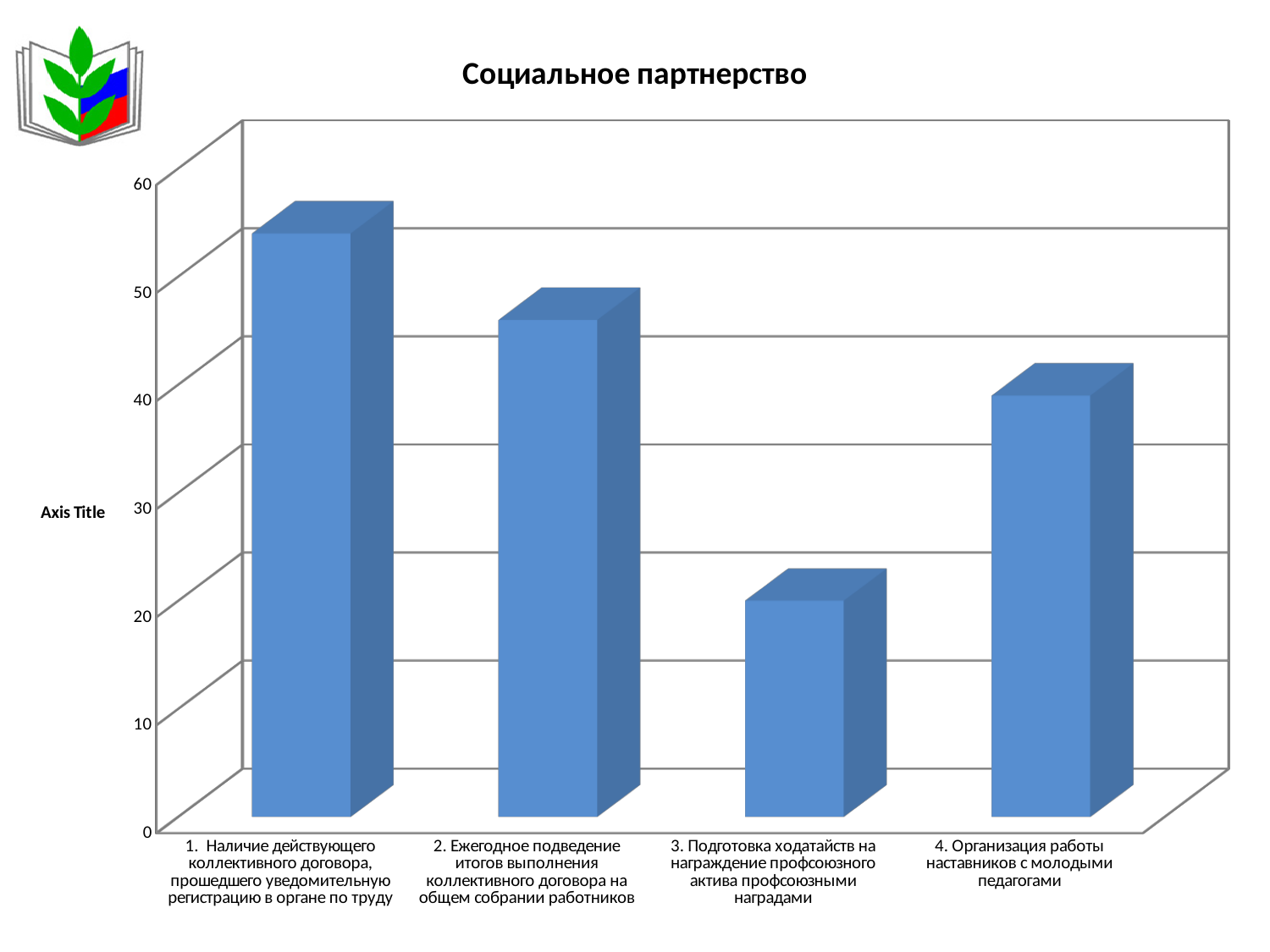
Which category has the lowest value? 3. Подготовка ходатайств на награждение профсоюзного актива профсоюзными наградами Which category has the highest value? 1. Наличие действующего коллективного договора, прошедшего уведомительную регистрацию в органе по труду What type of chart is shown on the slide? Bar chart Is the value for '2. Ежегодное подведение итогов выполнения коллективного договора...' greater or less than 50? less What label is shown on the vertical axis? Axis Title Is the value for '3. Подготовка ходатайств на награждение профсоюзного актива...' greater or less than 30? less Is the value for '1. Наличие действующего коллективного договора...' greater or less than 50? greater Which is larger: the value for '2. Ежегодное подведение итогов...' or the value for '4. Организация работы наставников...'? 2. Ежегодное подведение итогов выполнения коллективного договора на общем собрании работников How many categories (bars) are shown in the chart? 4 What is the title of the chart? Социальное партнерство